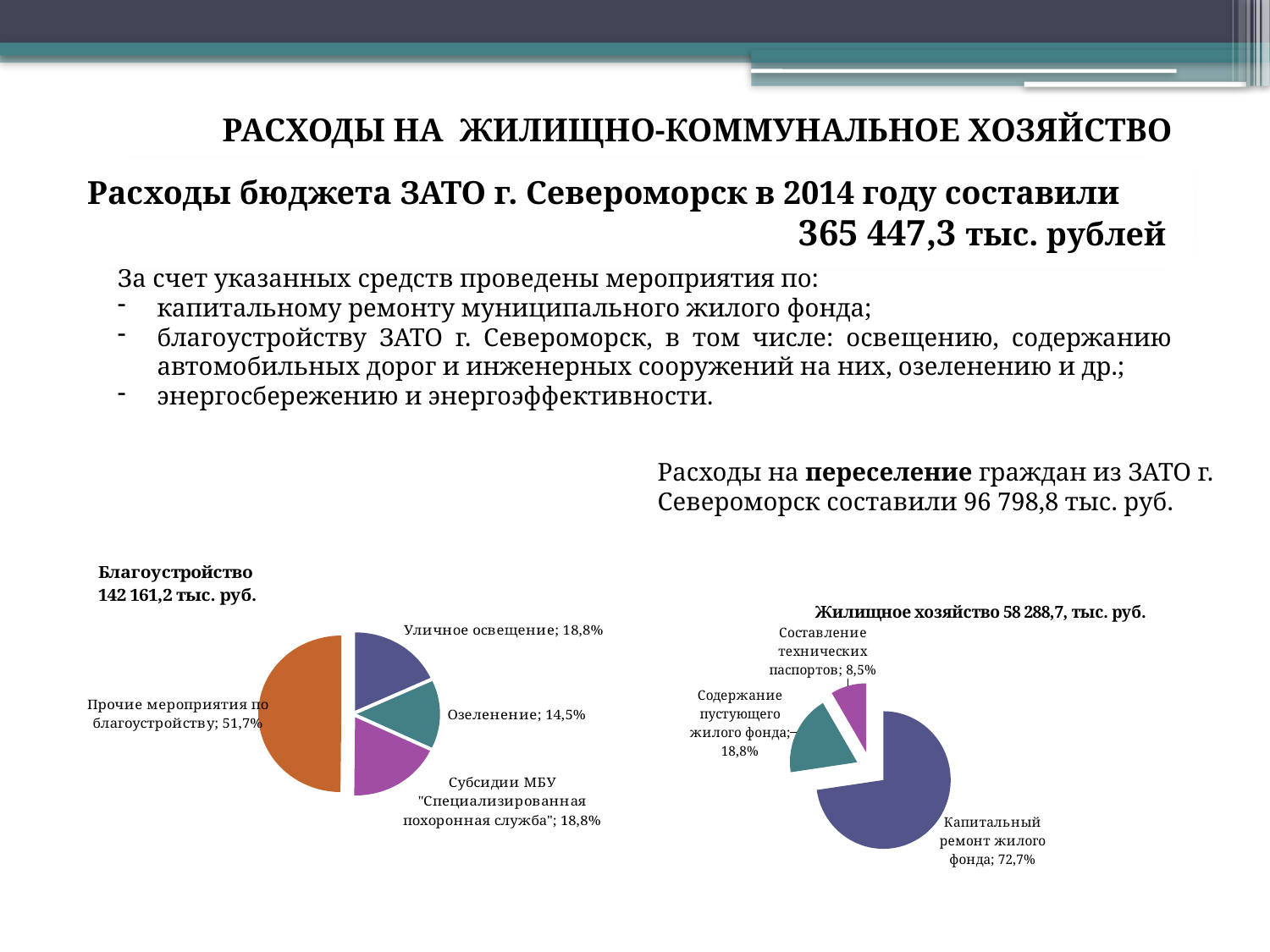
На диаграмме «Жилищное хозяйство» какая категория имеет наименьшую долю? Составление технических паспортов Сколько секторов на диаграмме «Жилищное хозяйство»? 3 На диаграмме «Благоустройство» какая категория имеет наименьшую долю? Озеленение На диаграмме «Благоустройство» какая категория имеет наибольшую долю? Прочие мероприятия по благоустройству На диаграмме «Благоустройство» на сколько процентных пунктов доля прочих мероприятий по благоустройству больше доли озеленения? 37,2 На диаграмме «Жилищное хозяйство» что больше: доля содержания пустующего жилого фонда или доля составления технических паспортов? Содержание пустующего жилого фонда Какого типа диаграмма «Жилищное хозяйство»? Круговая диаграмма Сколько секторов на диаграмме «Благоустройство»? 4 На диаграмме «Жилищное хозяйство» какая доля приходится на составление технических паспортов? 8,5% На диаграмме «Благоустройство» какая доля приходится на уличное освещение? 18,8% На диаграмме «Жилищное хозяйство» какая доля приходится на капитальный ремонт жилого фонда? 72,7% На диаграмме «Благоустройство» какая доля приходится на озеленение? 14,5%